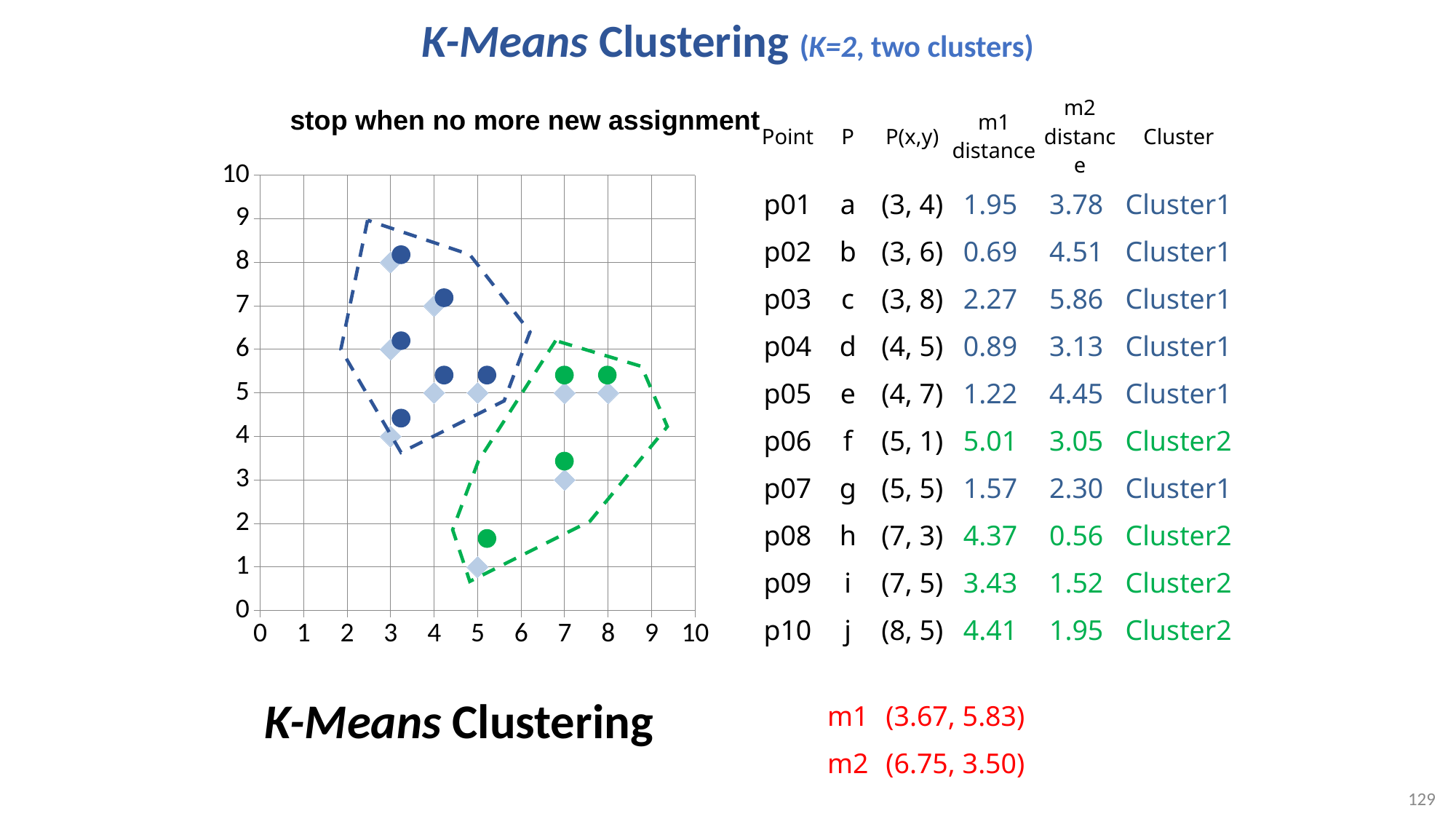
Which has the larger x value: the rightmost point in the green dashed outline or the leftmost point in the blue dashed outline? the rightmost point in the green outline How many green circle markers are drawn on the chart? 4 How many light-blue diamond data points are plotted on the chart? 10 How many plotted points lie on the horizontal grid line y = 5? 4 What are the coordinates of the plotted point with the lowest y value? (5, 1) Is the y value of the lowest point inside the green dashed outline greater or less than 2? less What is the maximum value shown on the chart's x axis? 10 What is the title printed above the chart? stop when no more new assignment What kind of chart is shown on the left of the slide? scatter chart What is the difference in x between the two points inside the green dashed outline that lie at y = 5? 1 What are the coordinates of the plotted point with the highest y value? (3, 8)